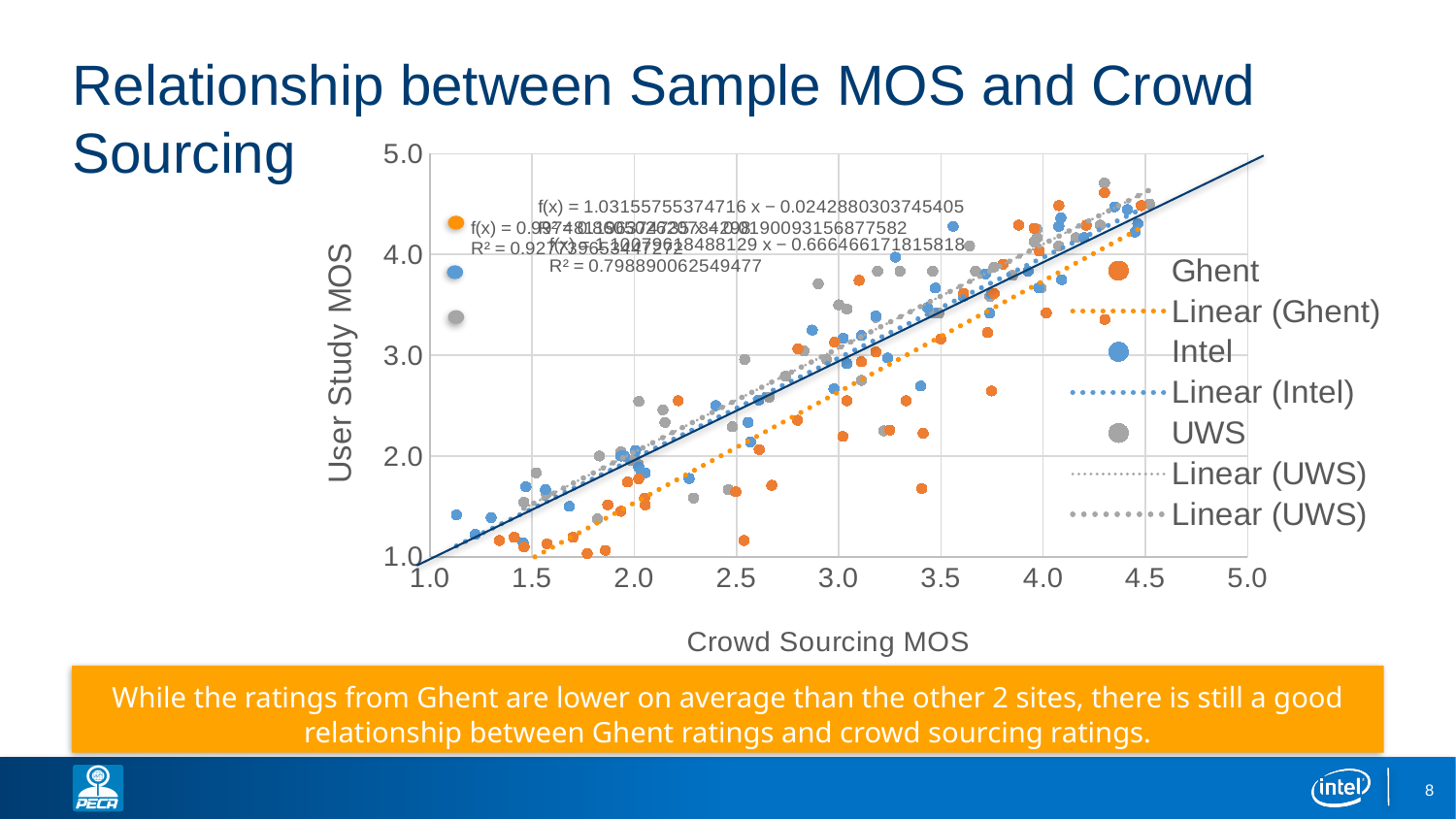
What is the title of the chart's y axis? User Study MOS Which site's ratings are described on the slide as lower on average than the other two sites? Ghent How many data series (sites) are plotted as points in the chart? 3 Which colour represents the Intel series in the chart? Blue Do the User Study MOS values generally rise or fall as Crowd Sourcing MOS increases? Rise What kind of chart is shown on the slide? Scatter chart How many entries does the chart legend list? 7